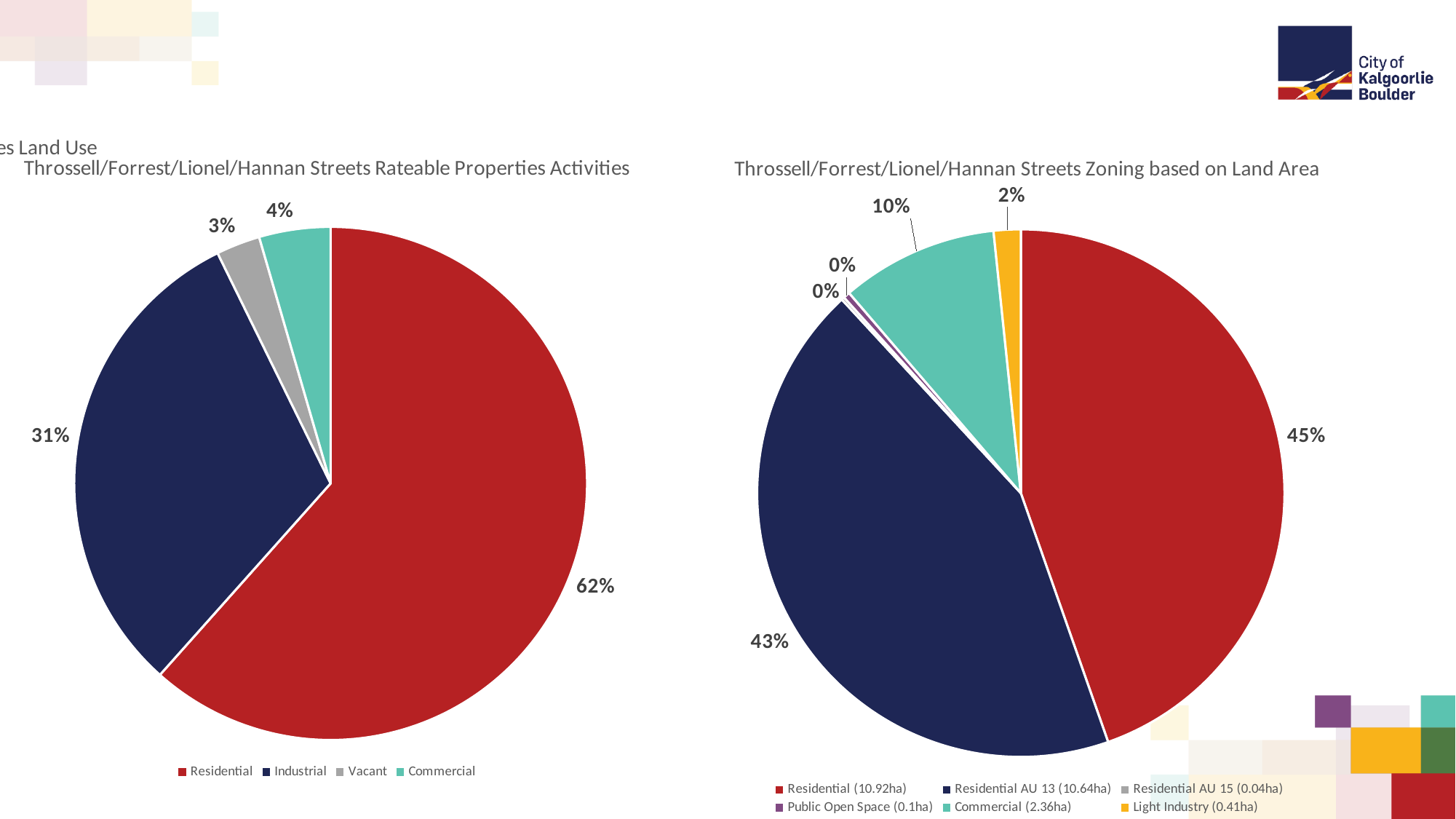
In the 'Zoning based on Land Area' pie chart, what share does Commercial (2.36ha) have? 10% In the 'Rateable Properties Activities' pie chart, what share does Vacant have? 3% In the 'Rateable Properties Activities' pie chart, which category has the largest slice? Residential What type of chart is the 'Zoning based on Land Area' chart? Pie chart In the 'Rateable Properties Activities' pie chart, what is the difference in percentage points between Residential and Industrial? 31 In the 'Rateable Properties Activities' pie chart, what share does Residential have? 62% In the 'Rateable Properties Activities' pie chart, how many categories does the legend list? 4 In the 'Zoning based on Land Area' pie chart, how many categories does the legend list? 6 In the 'Rateable Properties Activities' pie chart, which category has the smallest slice? Vacant